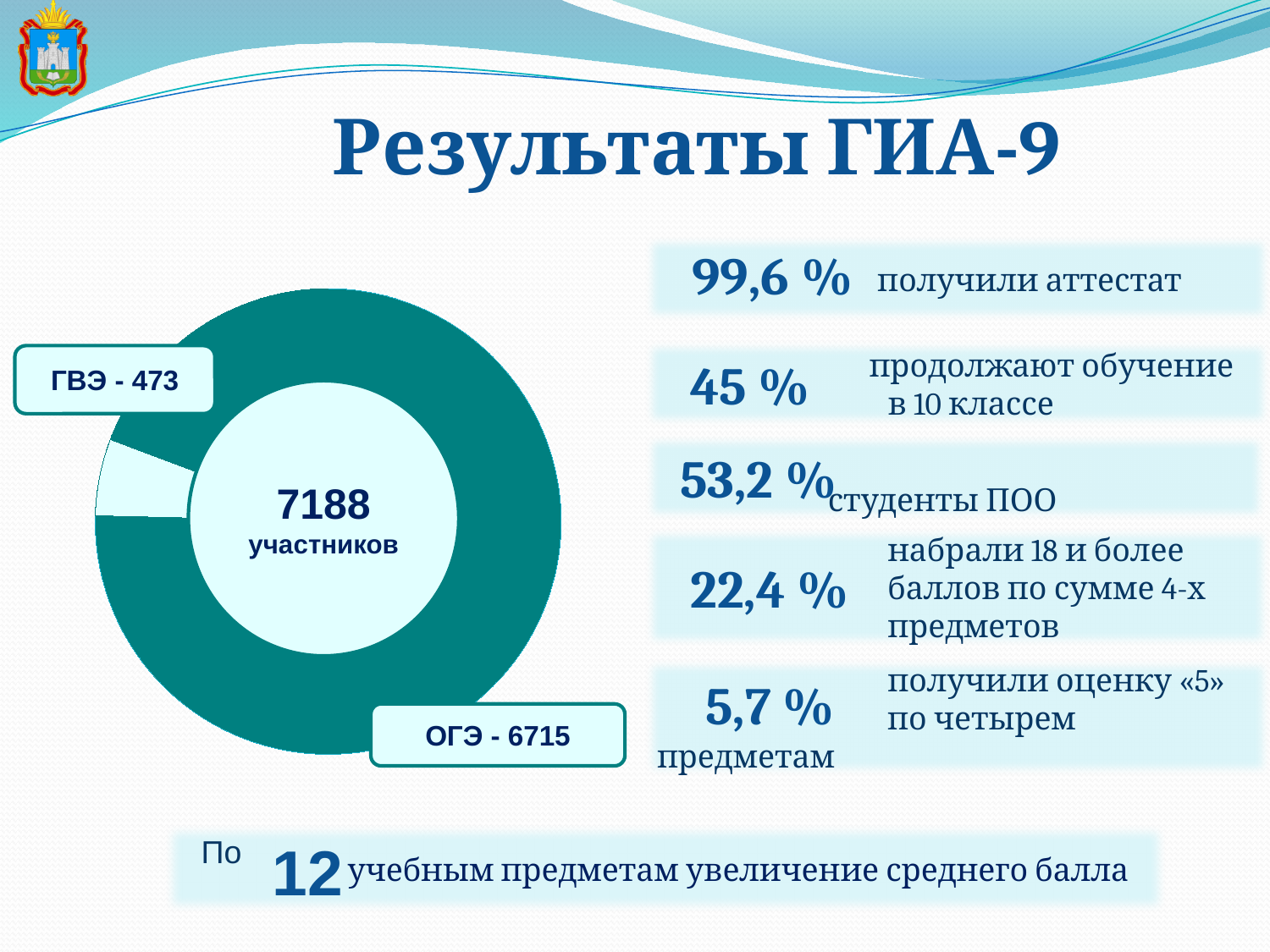
Which is larger in the doughnut chart, ОГЭ or ГВЭ? ОГЭ What is the value for ГВЭ in the doughnut chart? 473 What is the difference between the ОГЭ and ГВЭ values in the doughnut chart? 6242 What share of the total participants does the ГВЭ segment represent? 6,6 % Which segment of the doughnut chart is the smallest? ГВЭ Which segment of the doughnut chart is the largest? ОГЭ What kind of chart is shown on the slide? doughnut chart What colour is the ОГЭ segment of the doughnut chart? teal What is the value for ОГЭ in the doughnut chart? 6715 What is the title of the slide containing the doughnut chart? Результаты ГИА-9 What total number of participants is shown in the centre of the doughnut chart? 7188 участников How many segments does the doughnut chart have? 2